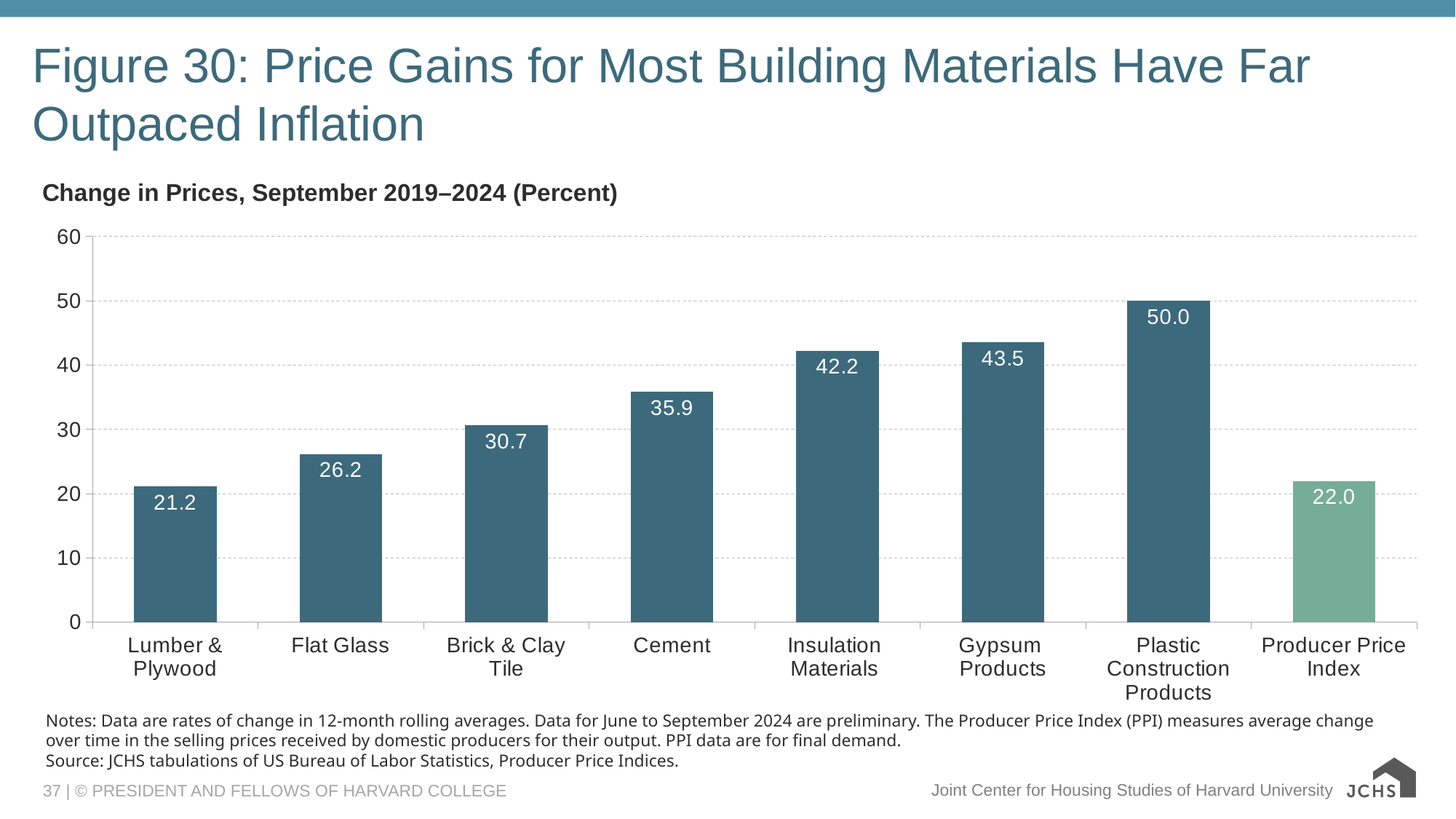
What is the change in prices for the Producer Price Index? 22.0 What is the change in prices for Cement? 35.9 What is the difference between the change in prices for Insulation Materials and Flat Glass? 16.0 Which category has the highest change in prices? Plastic Construction Products Which category has the lowest change in prices? Lumber & Plywood Is the change in prices for Flat Glass greater or less than 30? less Which has a larger change in prices, Brick & Clay Tile or Cement? Cement What kind of chart is shown on the slide? Bar chart How many categories are shown in the chart? 8 What is the difference between the change in prices for Plastic Construction Products and the Producer Price Index? 28.0 What is the change in prices for Gypsum Products? 43.5 What is the subtitle of the chart? Change in Prices, September 2019–2024 (Percent)